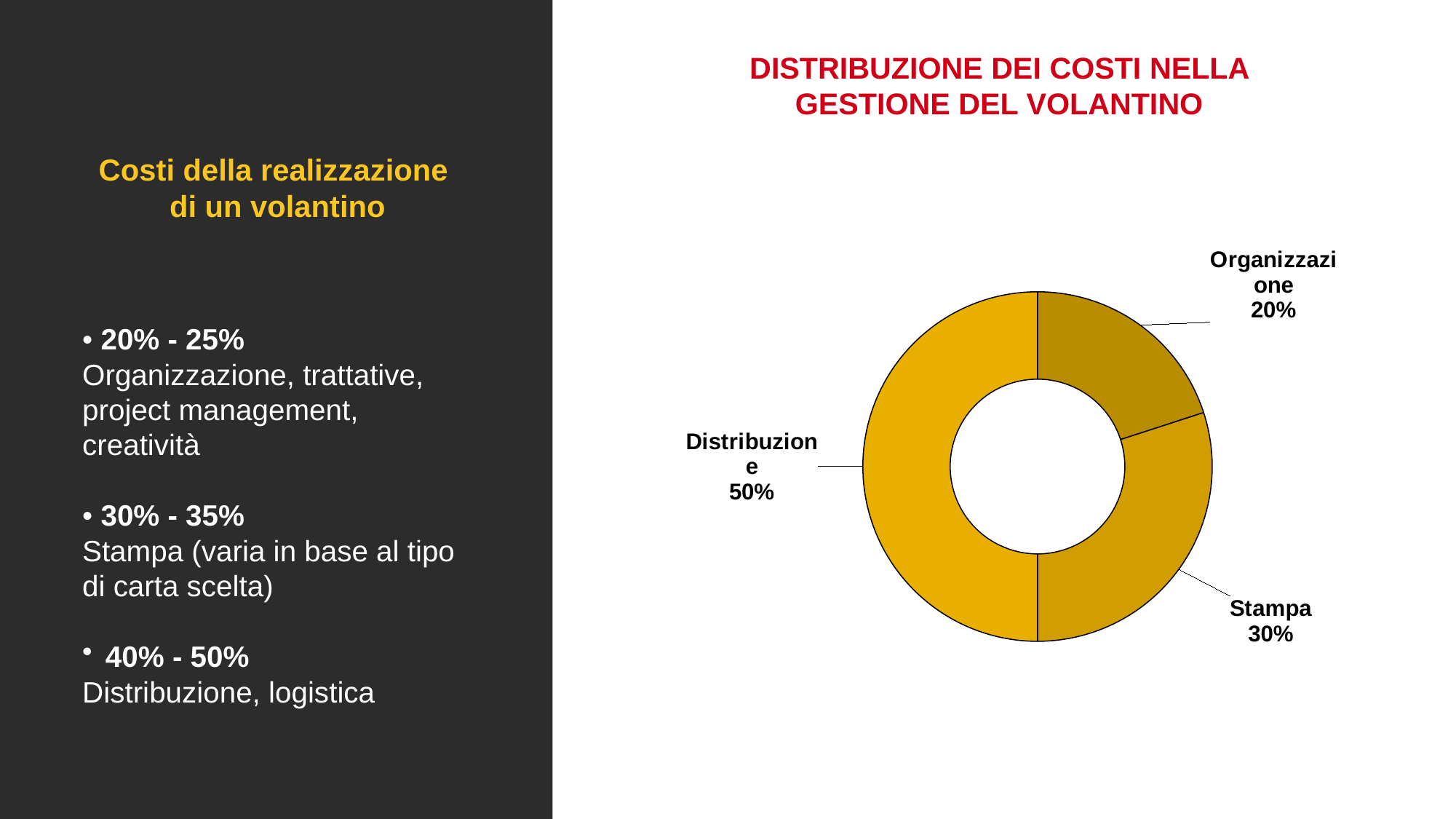
Which category has the largest share in the chart? Distribuzione What is the combined share of Stampa and Organizzazione? 50% Which category has the smallest share in the chart? Organizzazione What is the difference between the shares of Stampa and Organizzazione? 10% What is the title of the chart? DISTRIBUZIONE DEI COSTI NELLA GESTIONE DEL VOLANTINO What kind of chart is shown on the slide? Doughnut chart Which is larger, the share for Stampa or the share for Organizzazione? Stampa What share of the chart does Organizzazione represent? 20% What share of the chart does Distribuzione represent? 50% How many categories are shown in the chart? 3 What is the difference between the shares of Distribuzione and Stampa? 20% What share of the chart does Stampa represent? 30%